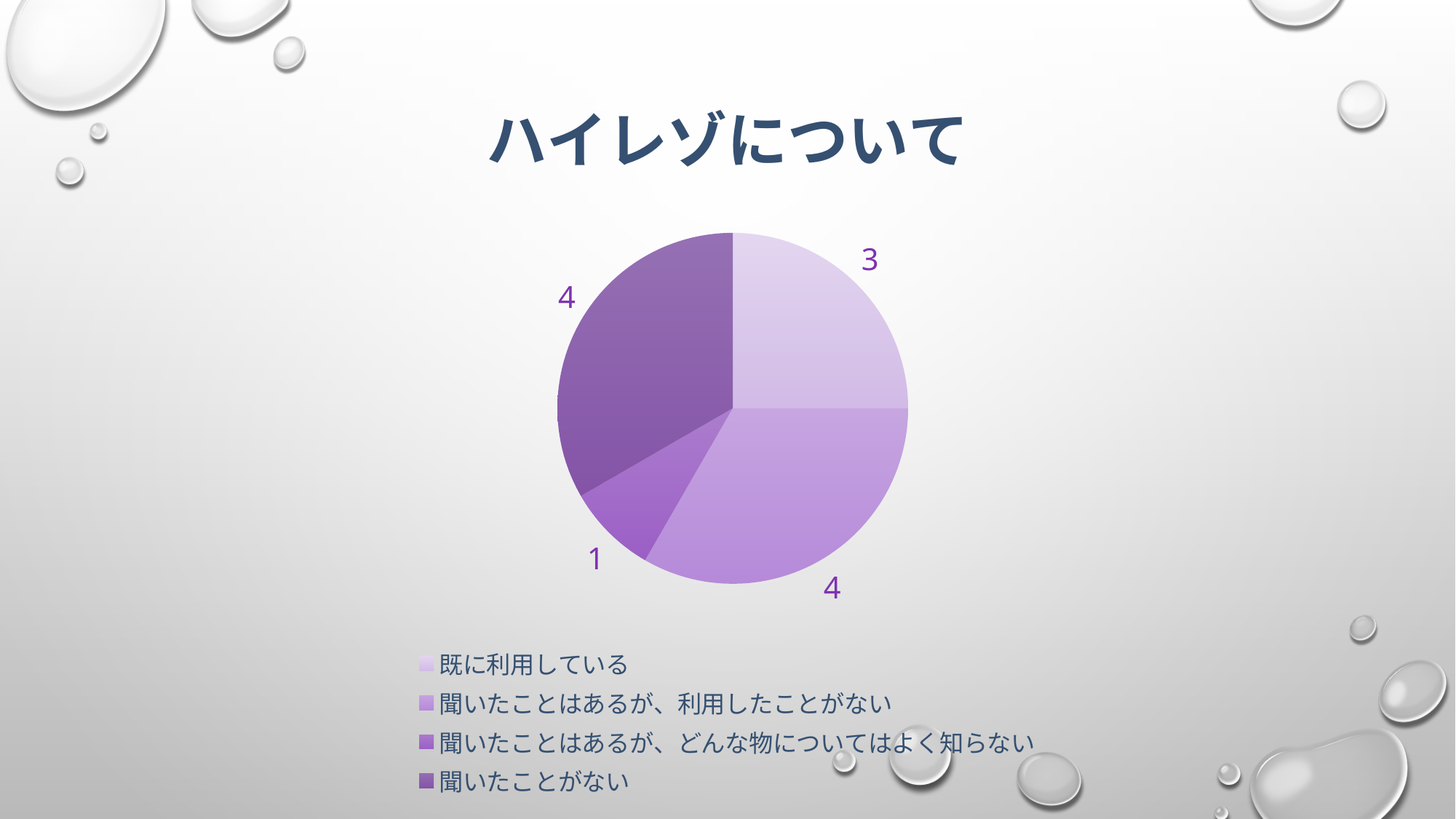
What is the value for 聞いたことはあるが、利用したことがない? 4 Which category has the smallest slice? 聞いたことはあるが、どんな物についてはよく知らない How many categories does the pie chart have? 4 Which is larger, the value for 既に利用している or the value for 聞いたことはあるが、どんな物についてはよく知らない? 既に利用している What is the difference between the values for 聞いたことがない and 既に利用している? 1 What is the title of the chart? ハイレゾについて What is the value for 聞いたことはあるが、どんな物についてはよく知らない? 1 What is the total of all slices in the pie chart? 12 What is the value for 既に利用している? 3 What kind of chart is shown on the slide? pie chart What is the value for 聞いたことがない? 4 What share of the pie does 既に利用している represent? 25%